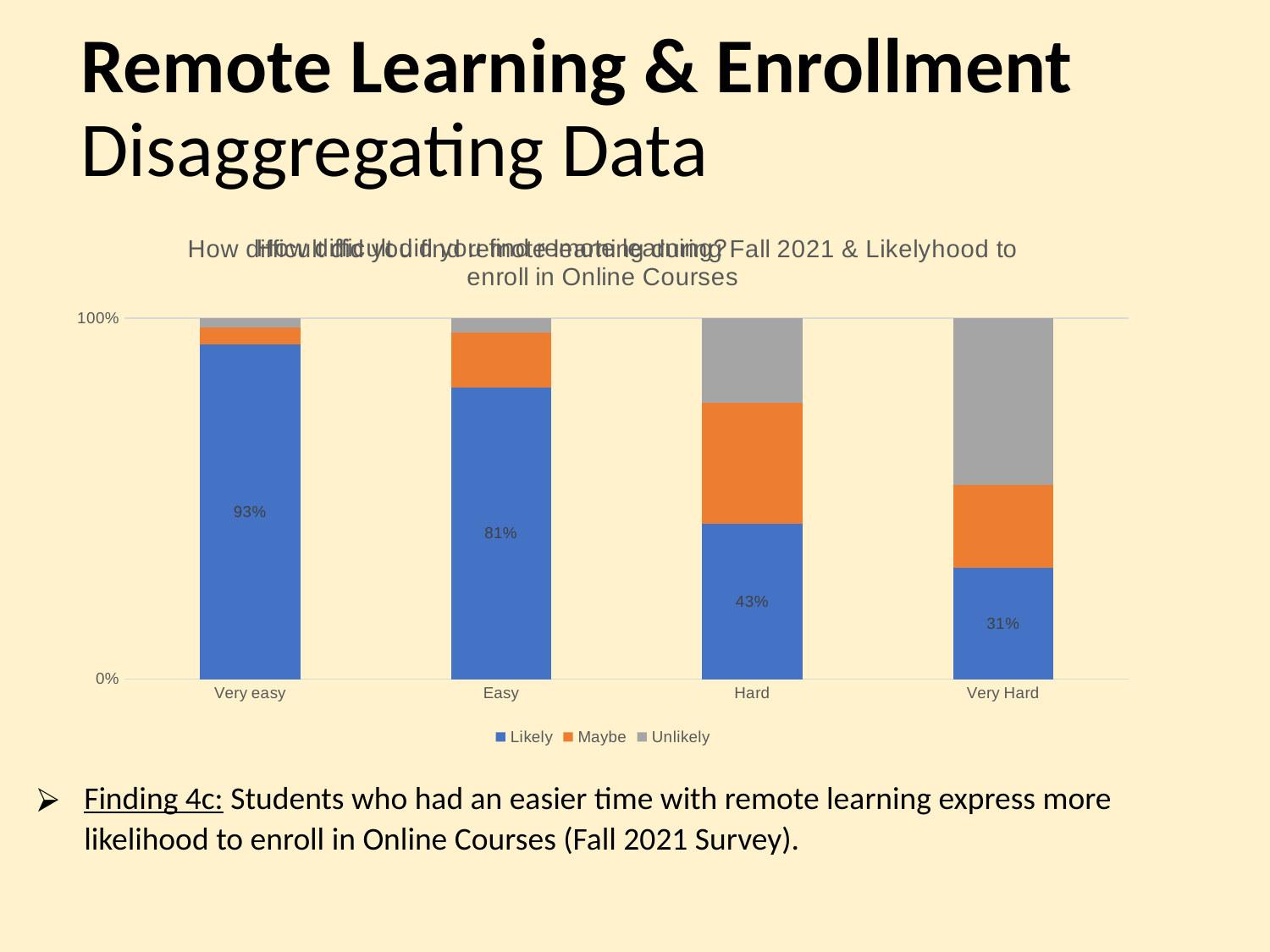
What is the Likely value for the Hard category? 43% Which category has the lowest Likely percentage? Very Hard How many categories are shown on the x axis? 4 Does the Likely percentage rise or fall moving from Very easy to Very Hard? Fall What is the difference between the Likely values for Very easy and Very Hard? 62% What is the Likely value for the Very Hard category? 31% What is the Likely value for the Easy category? 81% Which has a larger Likely value, Easy or Hard? Easy How many series does the legend list? 3 What percentage of students who found remote learning Very easy are Likely to enroll in online courses? 93% Which category has the highest Likely percentage? Very easy What kind of chart is shown on the slide? Stacked bar chart